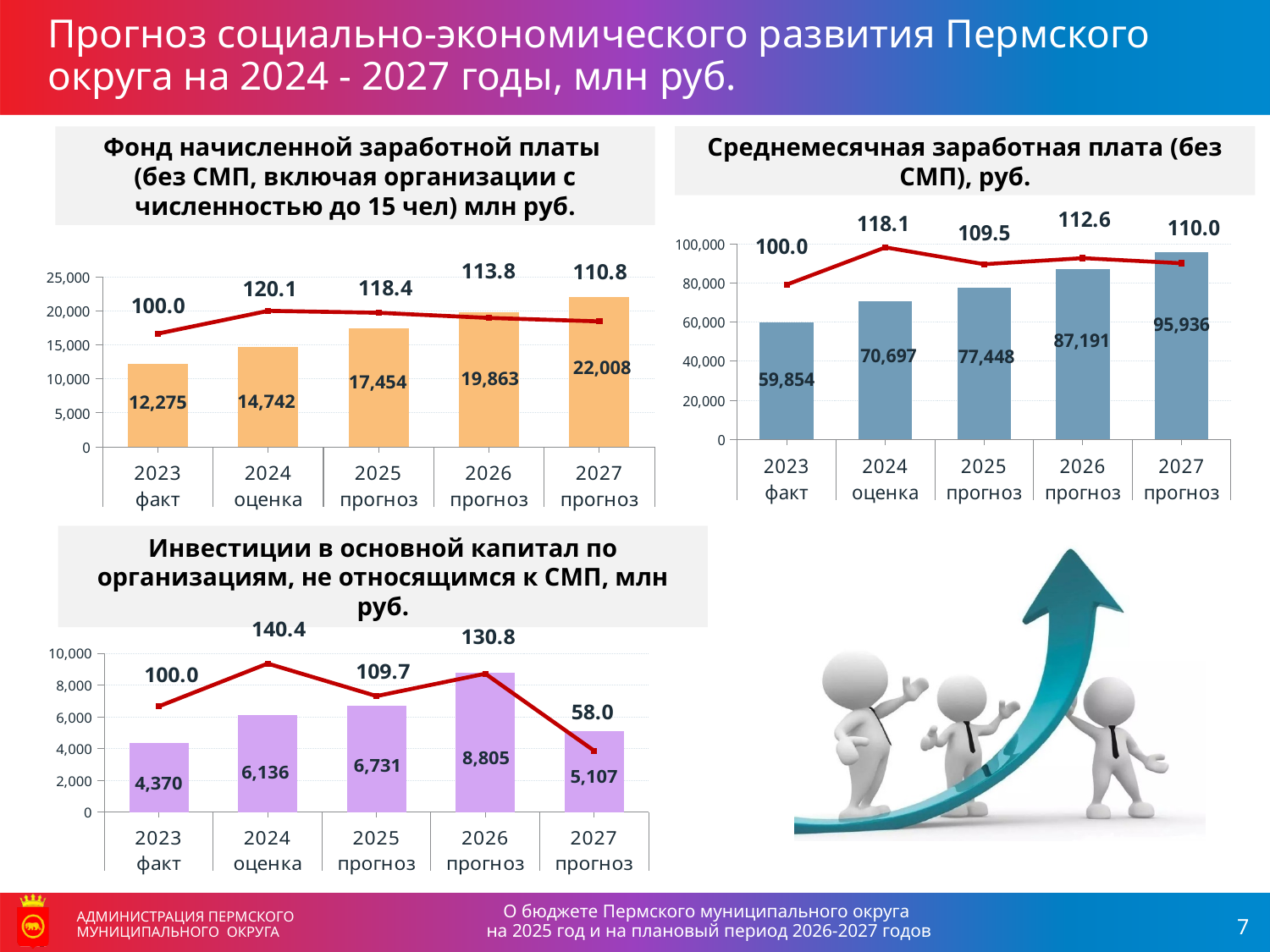
In the chart 'Инвестиции в основной капитал', which bar is larger: 2024 оценка or 2025 прогноз? 2025 прогноз In the chart 'Среднемесячная заработная плата (без СМП), руб.', what is the bar value for 2026 прогноз? 87,191 In the chart 'Фонд начисленной заработной платы', what is the line value shown above 2024 оценка? 120.1 In the chart 'Фонд начисленной заработной платы', what is the difference between the bar values for 2027 прогноз and 2023 факт? 9,733 In the chart 'Инвестиции в основной капитал', which year has the highest bar value? 2026 прогноз In the chart 'Среднемесячная заработная плата (без СМП), руб.', what is the line value shown above 2025 прогноз? 109.5 How many year categories are shown on the x axis of the chart 'Инвестиции в основной капитал'? 5 In the chart 'Среднемесячная заработная плата (без СМП), руб.', which year has the lowest bar value? 2023 факт In the chart 'Фонд начисленной заработной платы', which year has the highest bar value? 2027 прогноз In the chart 'Среднемесячная заработная плата (без СМП), руб.', do the bar values rise or fall from 2023 to 2027? rise In the chart 'Инвестиции в основной капитал', what is the bar value for 2027 прогноз? 5,107 In the chart 'Фонд начисленной заработной платы', what is the bar value for 2025 прогноз? 17,454